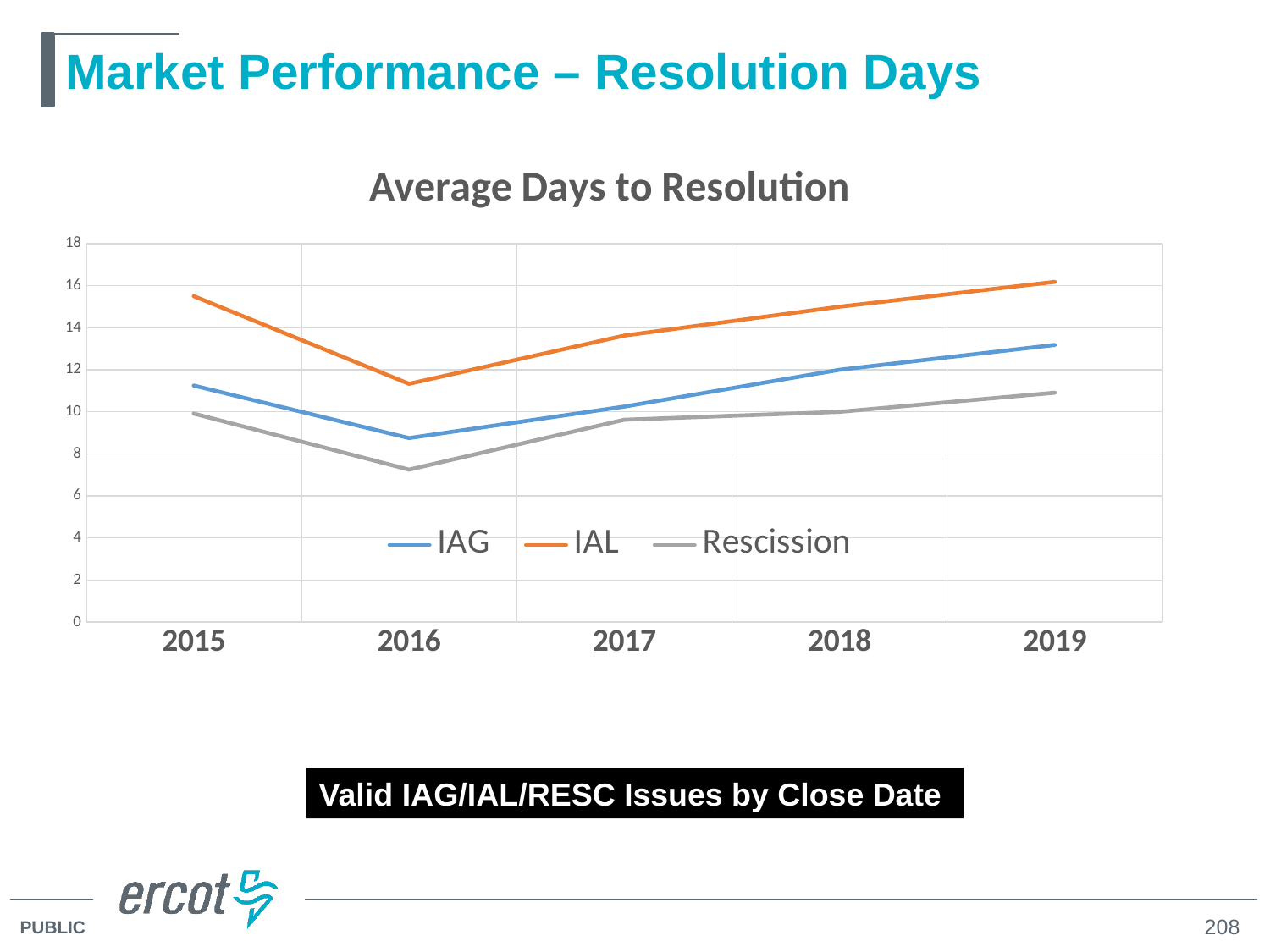
Which is larger in 2018, the IAG value or the Rescission value? IAG Is the value for IAL in 2015 greater or less than 14? greater How many series does the legend list? 3 Is the value for IAG in 2016 greater or less than 10? less What kind of chart is shown on the slide? Line chart Which series has the highest average days to resolution in 2017? IAL Which series has the lowest value in 2016? Rescission Do the IAL values rise or fall from 2016 to 2019? Rise Is the value for Rescission in 2016 greater or less than 8? less In which year is the IAL line at its highest? 2019 How many years are shown on the x axis? 5 In which year is the IAL line at its lowest? 2016